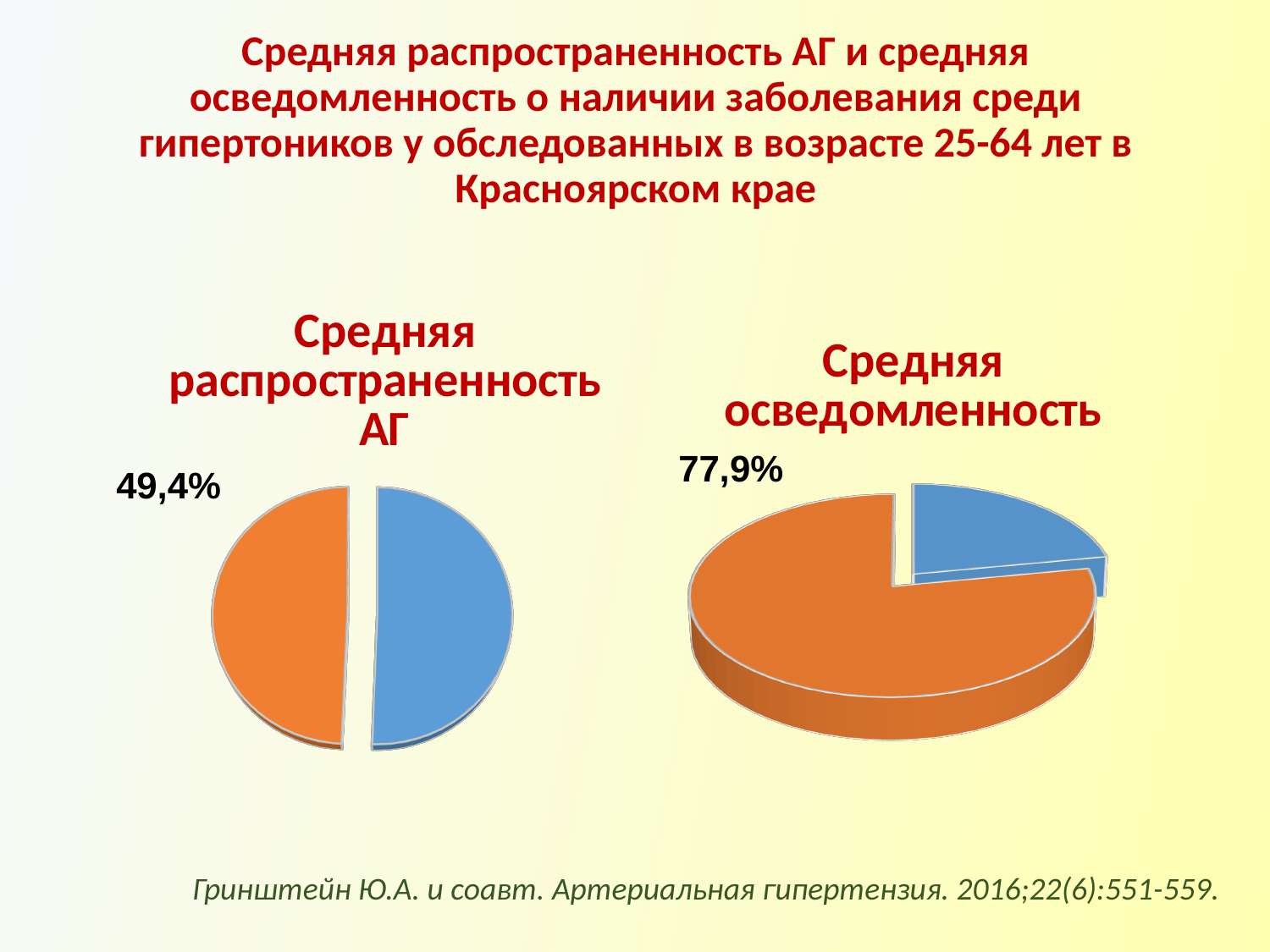
What is the difference between the labelled values of the two charts, 77,9% and 49,4%? 28,5% What is the title of the pie chart on the right of the slide? Средняя осведомленность Which chart has the larger labelled value, "Средняя распространенность АГ" or "Средняя осведомленность"? Средняя осведомленность How many slices does the "Средняя распространенность АГ" pie chart have? 2 In the "Средняя распространенность АГ" chart, what value is printed as the data label? 49,4% In the "Средняя осведомленность" chart, what value is printed as the data label? 77,9% What kind of chart is the "Средняя осведомленность" chart? pie chart What kind of chart is the "Средняя распространенность АГ" chart? pie chart How many slices does the "Средняя осведомленность" pie chart have? 2 In the "Средняя осведомленность" chart, which slice is larger, the orange one or the blue one? the orange one What is the title of the pie chart on the left of the slide? Средняя распространенность АГ